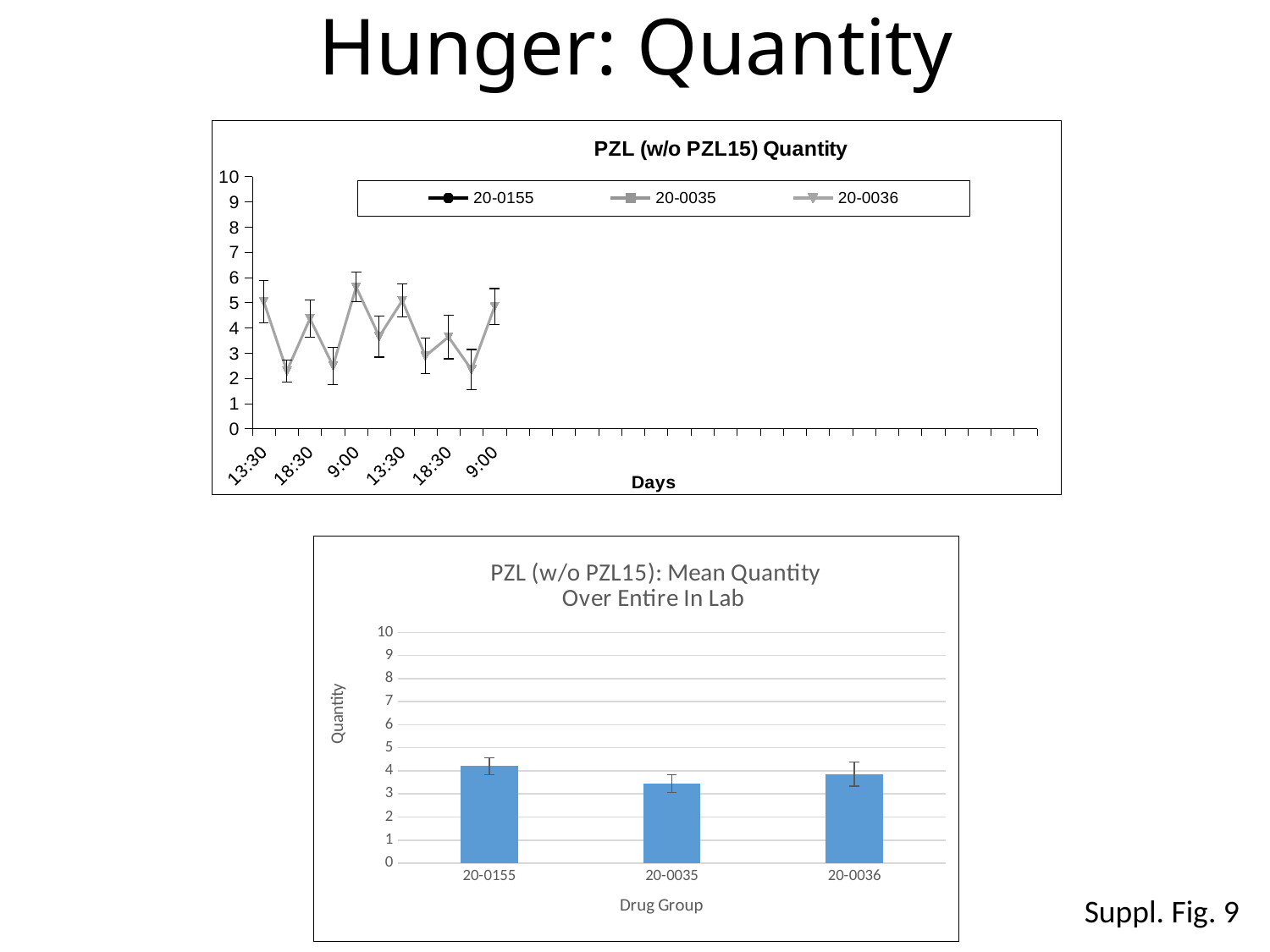
In the bottom chart "PZL (w/o PZL15): Mean Quantity Over Entire In Lab", how many drug groups are shown on the x axis? 3 In the bottom chart "PZL (w/o PZL15): Mean Quantity Over Entire In Lab", which drug group has the lowest mean quantity? 20-0035 In the bottom chart "PZL (w/o PZL15): Mean Quantity Over Entire In Lab", is the value for 20-0035 greater or less than 4? less In the top chart "PZL (w/o PZL15) Quantity", what is the label of the x axis? Days What kind of chart is the top chart titled "PZL (w/o PZL15) Quantity"? line chart In the bottom chart "PZL (w/o PZL15): Mean Quantity Over Entire In Lab", is the value for 20-0155 greater or less than 4? greater In the bottom chart "PZL (w/o PZL15): Mean Quantity Over Entire In Lab", is the value for 20-0036 greater or less than 3? greater In the bottom chart "PZL (w/o PZL15): Mean Quantity Over Entire In Lab", what is the label of the y axis? Quantity In the bottom chart "PZL (w/o PZL15): Mean Quantity Over Entire In Lab", which has the larger mean quantity, 20-0155 or 20-0035? 20-0155 In the top chart "PZL (w/o PZL15) Quantity", how many series does the legend list? 3 What kind of chart is the bottom chart titled "PZL (w/o PZL15): Mean Quantity Over Entire In Lab"? bar chart In the bottom chart "PZL (w/o PZL15): Mean Quantity Over Entire In Lab", which drug group has the highest mean quantity? 20-0155